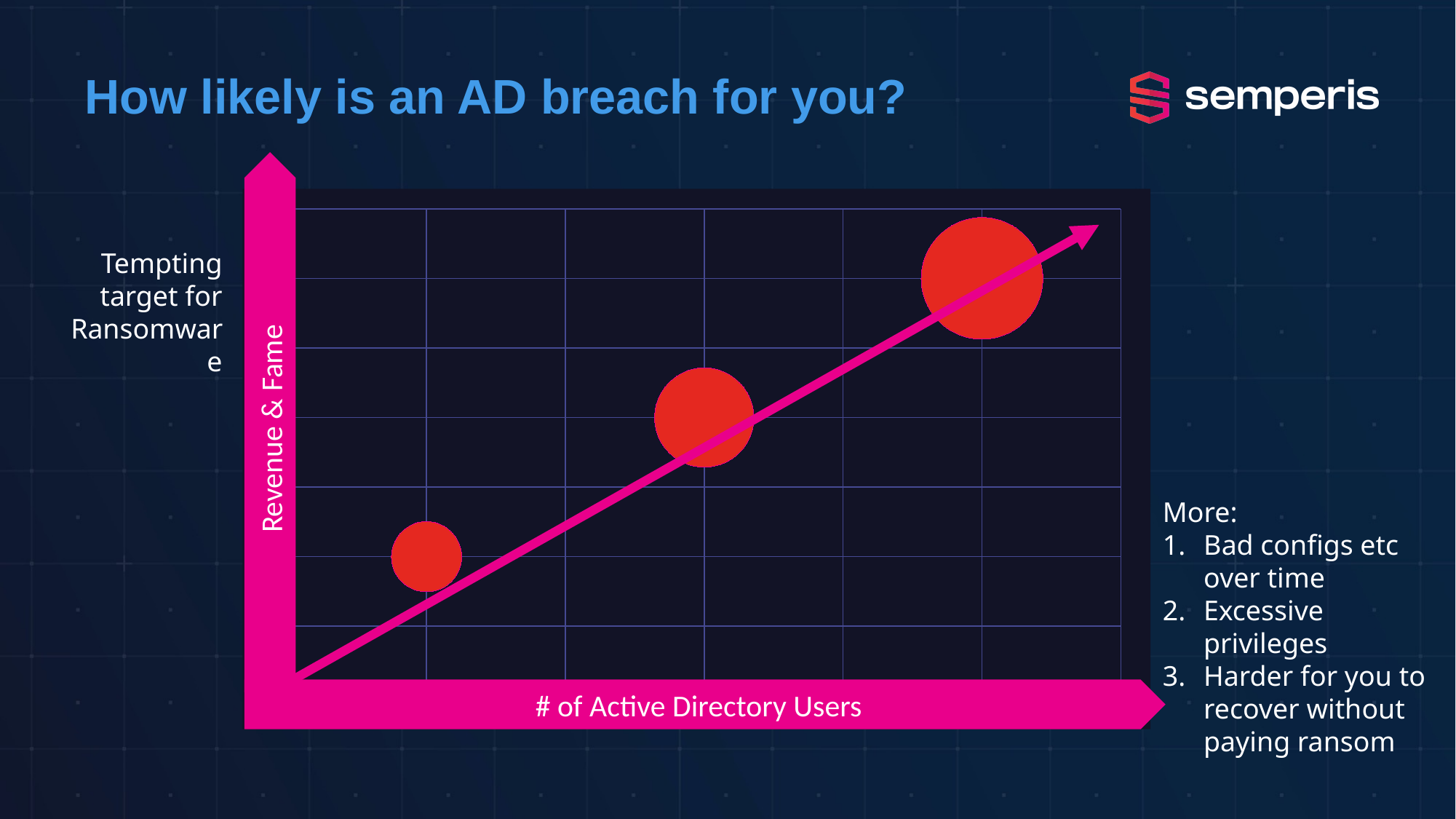
What is the title of the chart on the slide? How likely is an AD breach for you? Which circle is positioned higher on the y axis, the leftmost circle or the rightmost circle? rightmost circle What is the label on the x axis of the chart? # of Active Directory Users What kind of chart is shown on the slide? bubble chart Which plotted circle is the largest: the leftmost, the middle, or the rightmost? rightmost Which plotted circle is the smallest: the leftmost, the middle, or the rightmost? leftmost How many data points (red circles) are plotted on the chart? 3 Do the plotted points rise or fall as you move from left to right along the x axis? rise